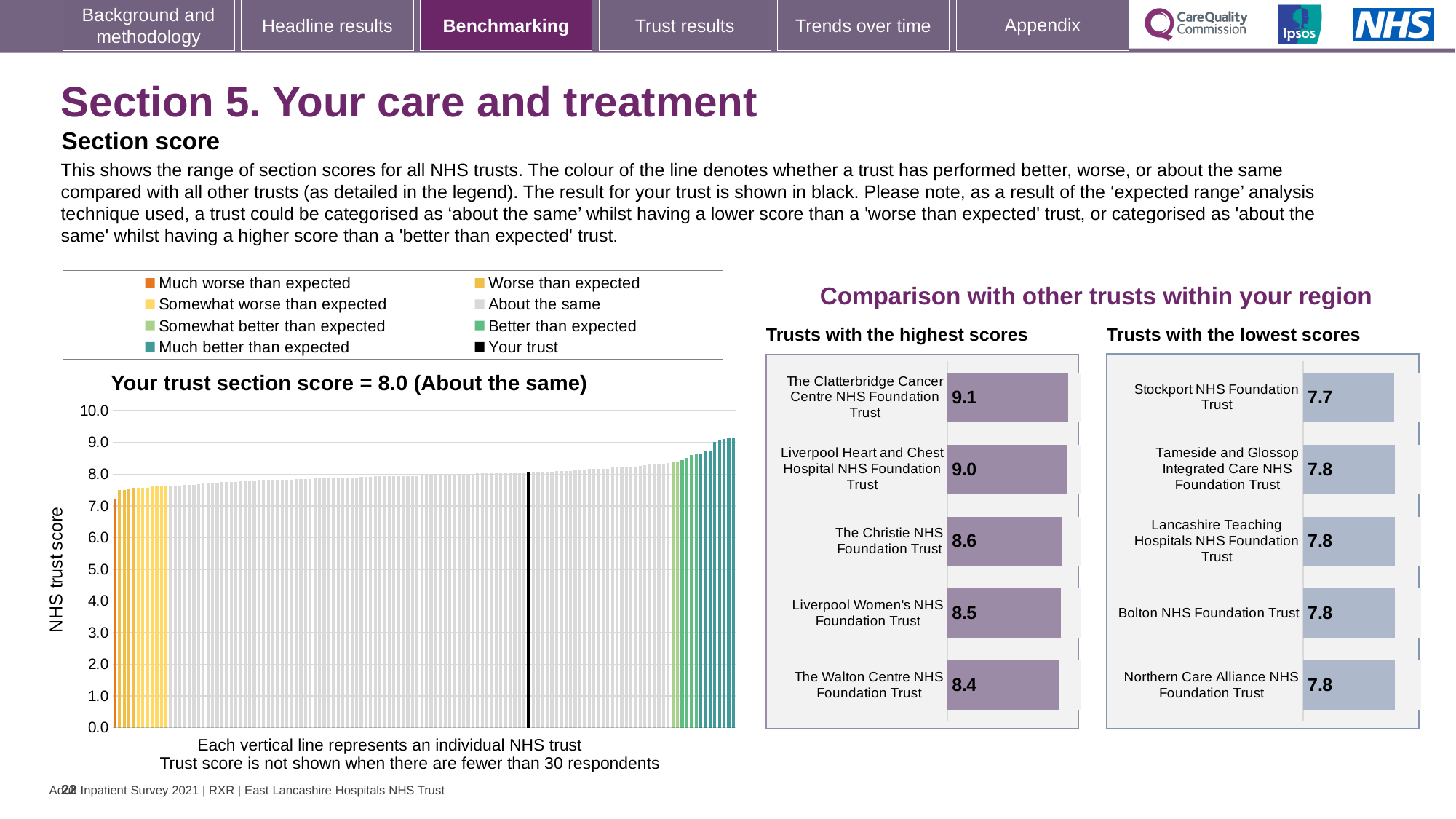
How many trusts are shown in the 'Trusts with the lowest scores' chart? 5 In the 'Trusts with the highest scores' chart, what is the score for The Clatterbridge Cancer Centre NHS Foundation Trust? 9.1 In the 'Trusts with the highest scores' chart, which has the higher score: The Christie NHS Foundation Trust or Liverpool Women's NHS Foundation Trust? The Christie NHS Foundation Trust In the 'Trusts with the lowest scores' chart, what is the score for Stockport NHS Foundation Trust? 7.7 How many entries does the legend above the main chart on the left list? 8 In the 'Trusts with the highest scores' chart, which trust has the highest score? The Clatterbridge Cancer Centre NHS Foundation Trust In the 'Trusts with the highest scores' chart, what is the difference between the scores of The Clatterbridge Cancer Centre NHS Foundation Trust and The Walton Centre NHS Foundation Trust? 0.7 In the 'Trusts with the highest scores' chart, what is the score for The Walton Centre NHS Foundation Trust? 8.4 In the 'Trusts with the lowest scores' chart, which trust has the lowest score? Stockport NHS Foundation Trust How many trusts are shown in the 'Trusts with the highest scores' chart? 5 What kind of chart is the main chart on the left showing all NHS trusts? Bar chart In the main chart on the left, what is your trust's section score according to the chart title? 8.0